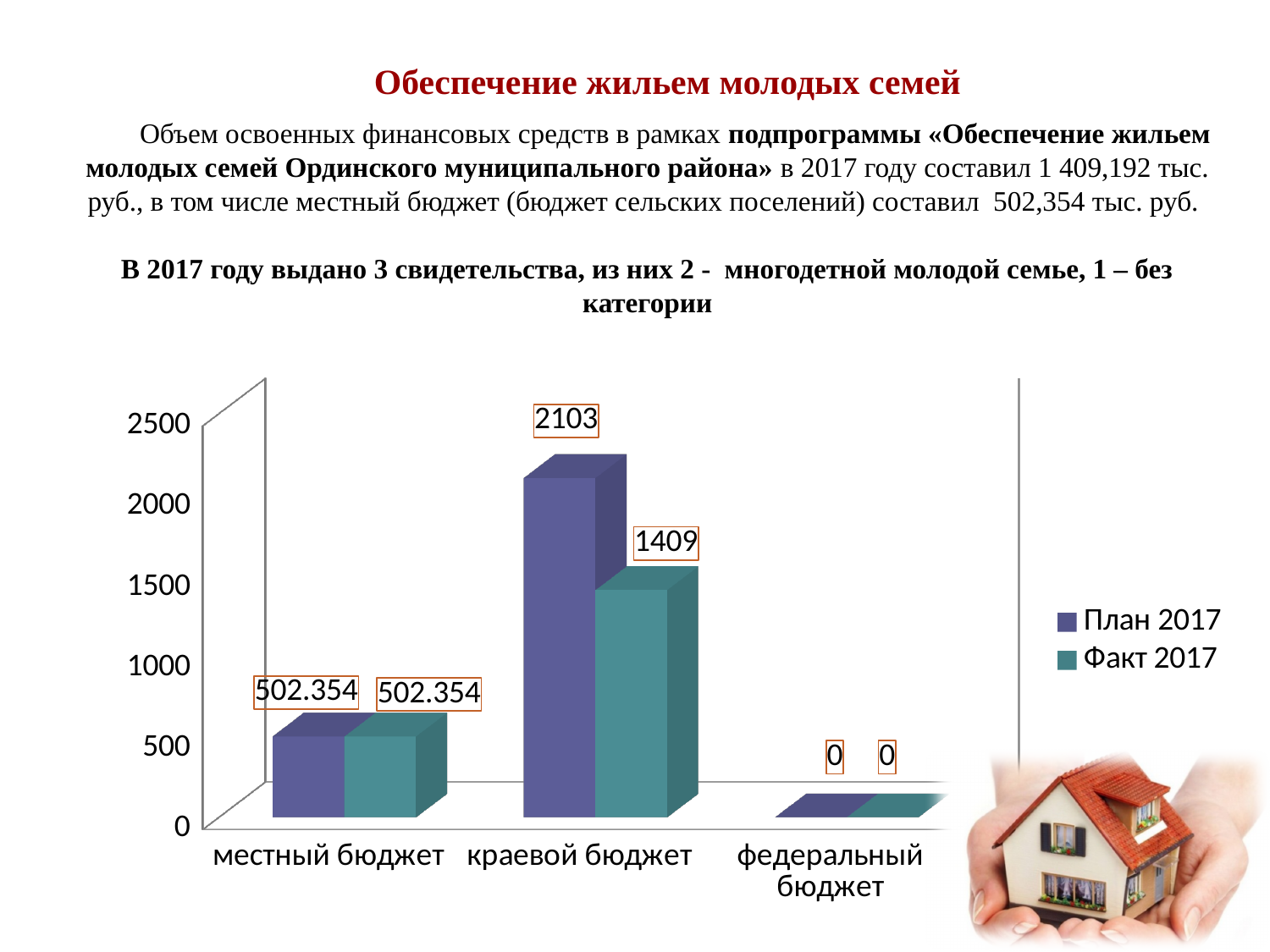
How many categories are shown on the x axis? 3 What is the Факт 2017 value for краевой бюджет? 1409 What is the План 2017 value for федеральный бюджет? 0 Which category has the lowest Факт 2017 value? федеральный бюджет Which category has the highest План 2017 value? краевой бюджет What is the difference between the План 2017 and Факт 2017 values for краевой бюджет? 694 What kind of chart is shown on the slide? bar chart How many series does the legend list? 2 Which is larger for краевой бюджет: План 2017 or Факт 2017? План 2017 What is the Факт 2017 value for местный бюджет? 502.354 Is the Факт 2017 value for краевой бюджет greater or less than 1000? greater What is the План 2017 value for краевой бюджет? 2103